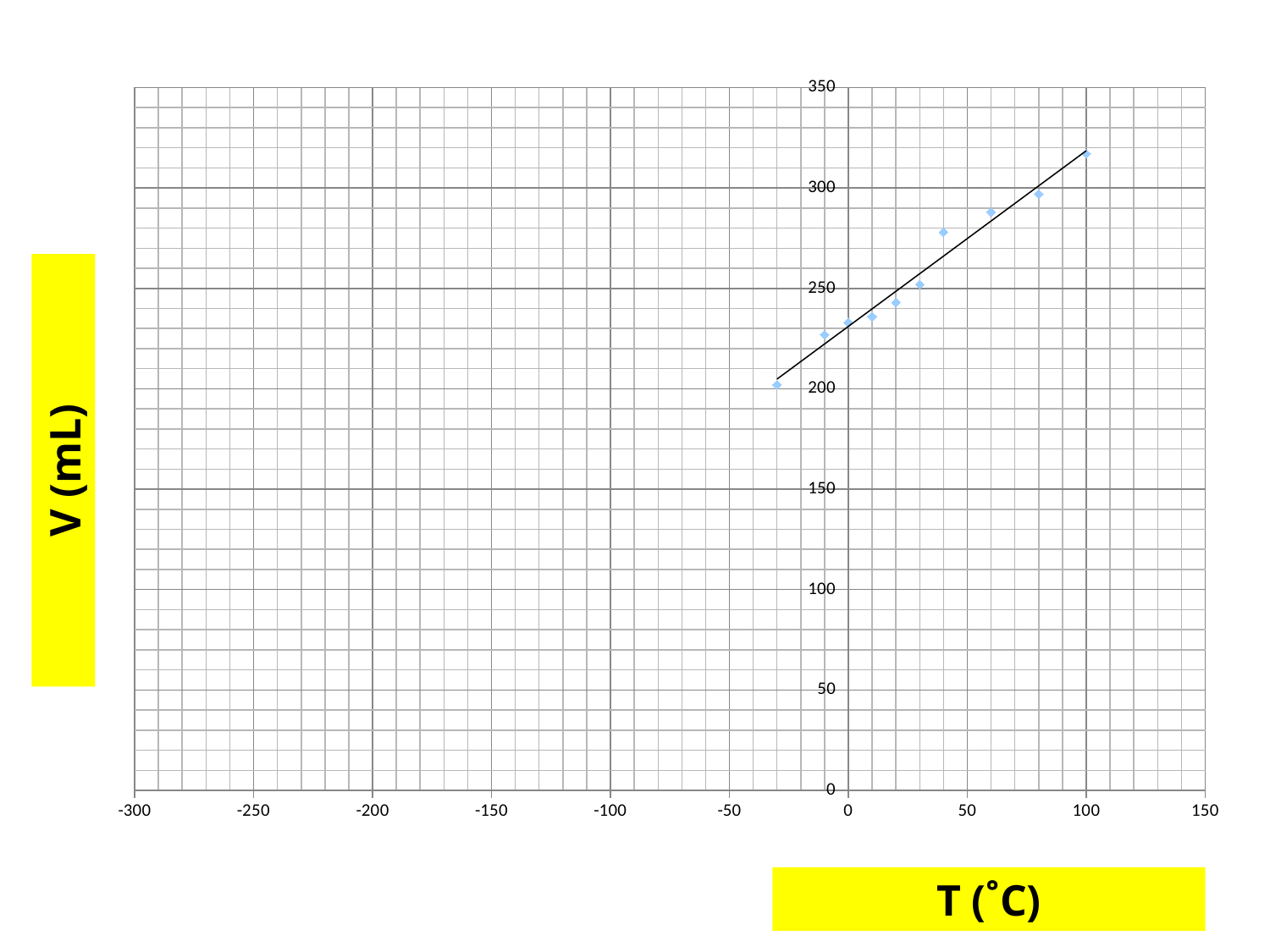
Do the plotted values rise or fall as T increases along the x axis? rise Is the value of V at T = 0 greater or less than 200? greater At which T value does the plotted V reach its highest value? 100 What is the label on the vertical axis of the chart? V (mL) How many data points are plotted on the chart? 10 Which plotted point has the highest V value, the one at T = 100 or the one at T = -30? T = 100 What is the label on the horizontal axis of the chart? T (˚C) What kind of chart is shown on the slide? scatter chart Is the value of V at T = -30 greater or less than 250? less At which T value does the plotted V reach its lowest value? -30 Is the value of V at T = 100 greater or less than 300? greater